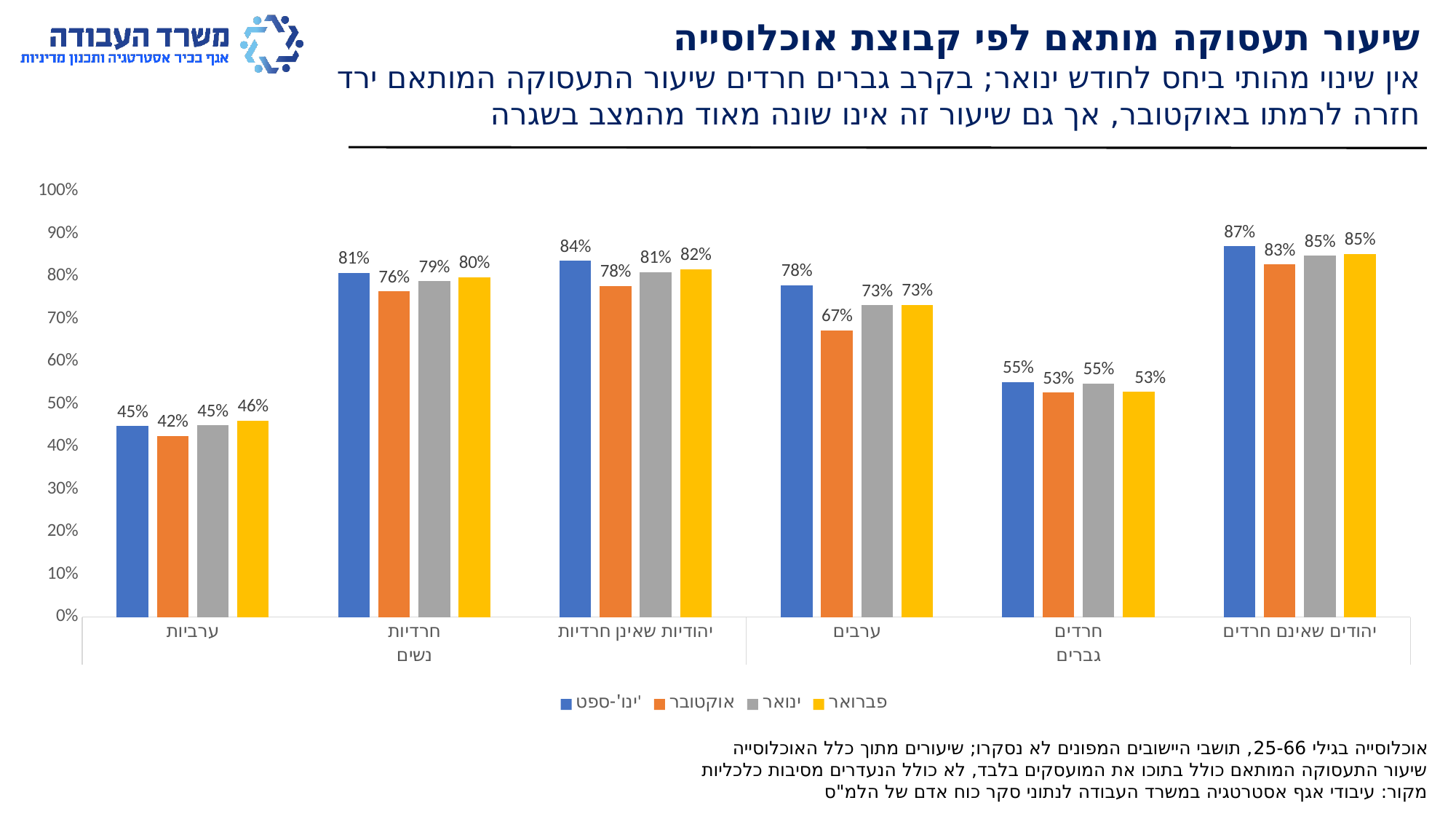
Is the value for ערביות in the פברואר series greater or less than 50%? less Which category has the highest value in the ינואר series? יהודים שאינם חרדים What is the value for חרדיות in the פברואר series? 80% What is the difference between the ינו'-ספט and אוקטובר values for ערבים? 11% Which colour represents the פברואר series? yellow Which is larger for חרדים: the ינואר value or the פברואר value? ינואר What is the value for יהודים שאינם חרדים in the ינו'-ספט series? 87% How many series does the legend list? 4 Which category has the lowest value in the אוקטובר series? ערביות What kind of chart is shown on the slide? bar chart How many population groups (categories) are shown on the x axis? 6 What is the value for ערבים in the אוקטובר series? 67%